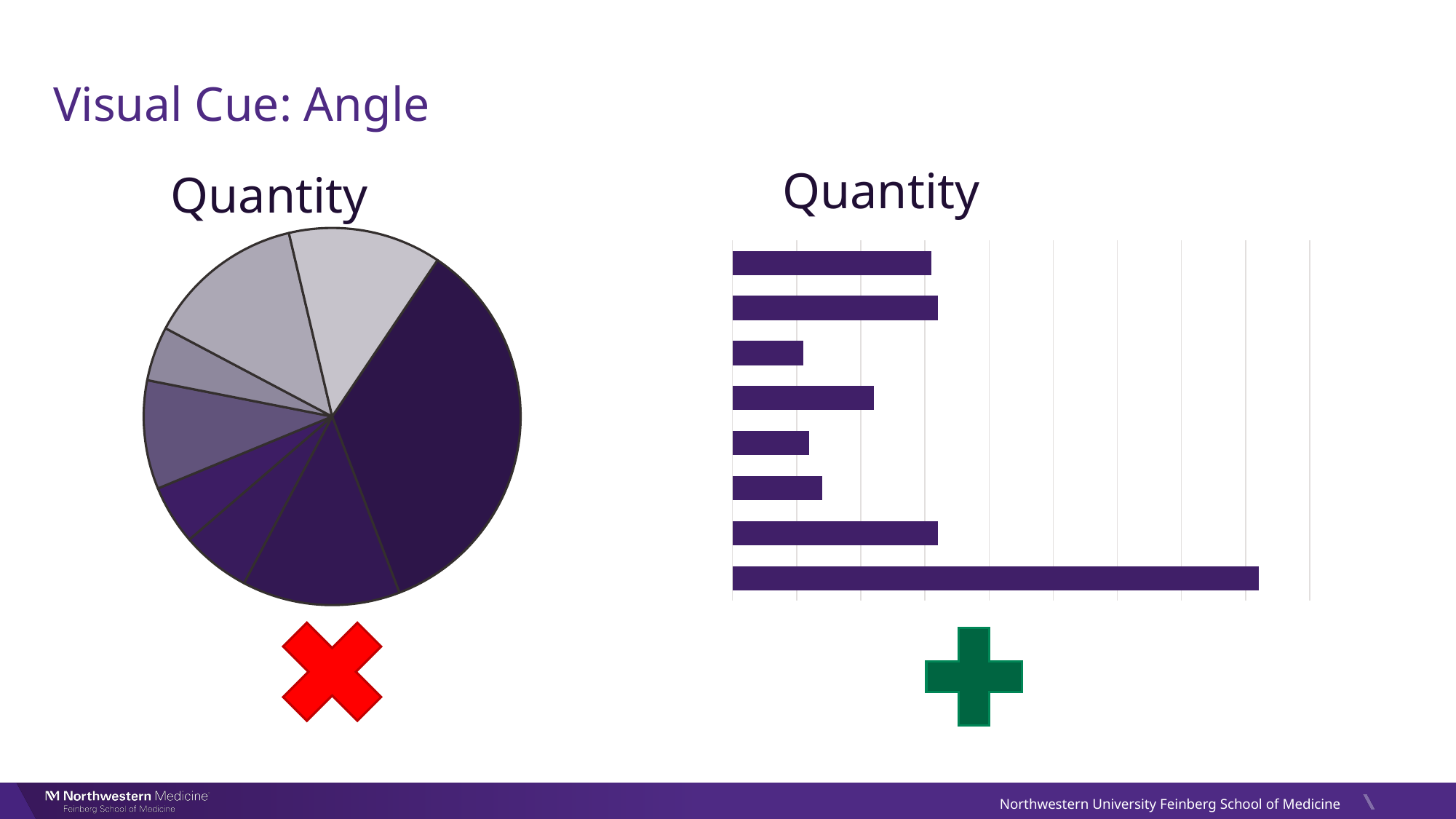
In the bar chart on the right, which bar is the shortest? the third bar from the top In the bar chart on the right, which bar is the longest? the bottom bar What kind of chart is the chart on the left of the slide? pie chart In the pie chart on the left, which slice is the largest? the dark purple slice on the right Are the bars in the chart on the right horizontal or vertical? horizontal How many bars does the bar chart on the right have? 8 What is the title of the bar chart on the right? Quantity In the bar chart on the right, is the fourth bar from the top longer or shorter than the fifth bar from the top? longer What kind of chart is the chart on the right of the slide? bar chart In the bar chart on the right, is the bottom bar longer or shorter than the top bar? longer How many slices does the pie chart on the left have? 8 What is the title of the pie chart on the left? Quantity